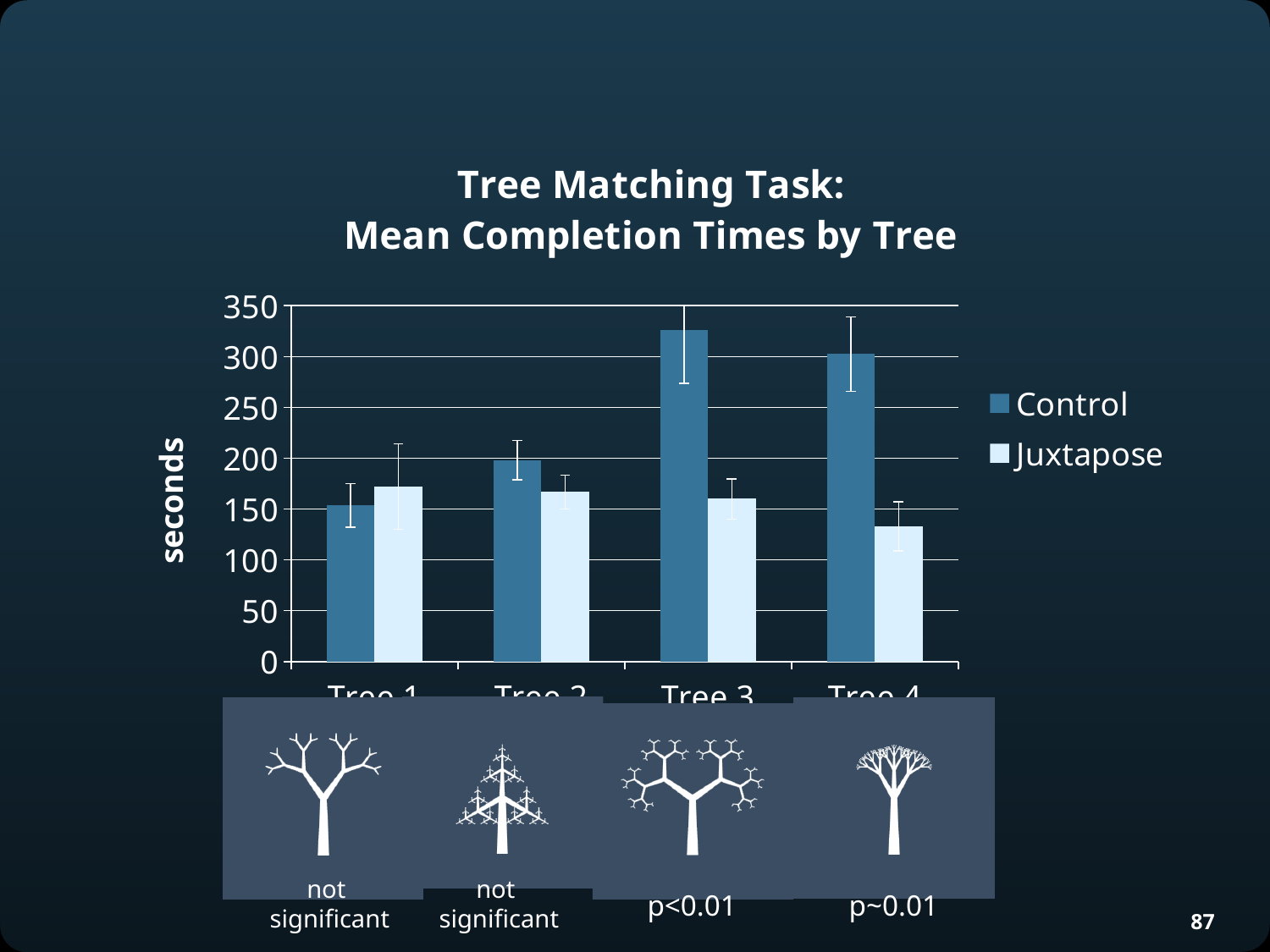
Is the Control value for Tree 3 greater or less than 300? greater For Tree 3, which series has the larger value, Control or Juxtapose? Control Which tree has the lowest Control completion time? Tree 1 What are the two series named in the legend? Control and Juxtapose For Tree 1, which series has the larger value, Control or Juxtapose? Juxtapose Which tree has the lowest Juxtapose completion time? Tree 4 How many tree categories are plotted on the x axis? 4 How many series does the legend list? 2 Which tree has the highest Control completion time? Tree 3 Is the Juxtapose value for Tree 4 greater or less than 150? less What is the label on the y axis? seconds What kind of chart is shown on the slide? bar chart